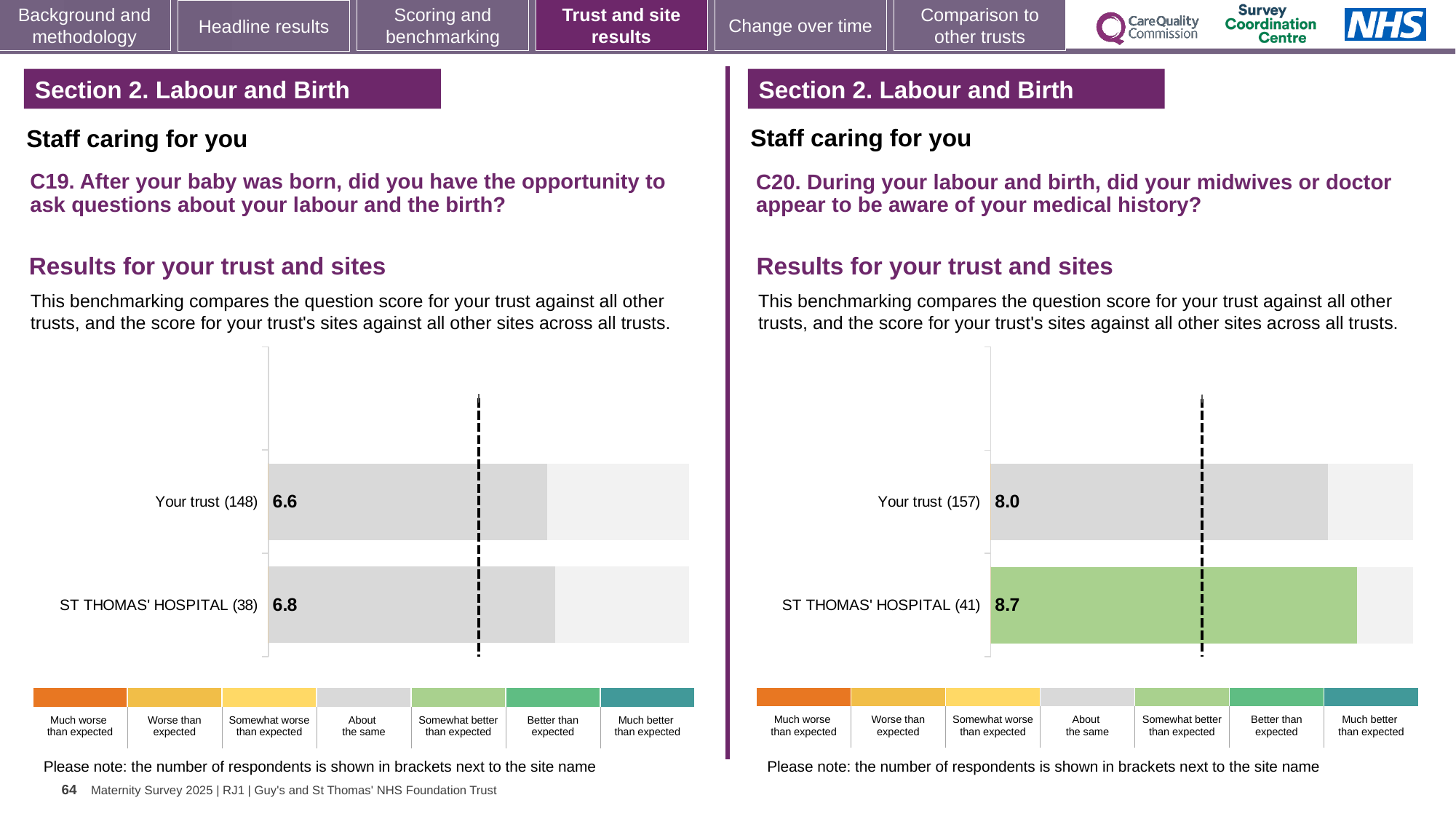
In the C19 chart on the left, what is the difference between the ST THOMAS' HOSPITAL score and the Your trust score? 0.2 How many bars are plotted in the C20 chart on the right? 2 In the C19 chart on the left, what is the score for Your trust? 6.6 In the C19 chart on the left, which bar has the lower score? Your trust In the C20 chart on the right, what is the difference between the ST THOMAS' HOSPITAL score and the Your trust score? 0.7 In the C20 chart on the right, which benchmark category does the colour of the ST THOMAS' HOSPITAL bar correspond to in the legend? Somewhat better than expected What type of chart is used in the C19 chart on the left? bar chart In the C20 chart on the right, which bar has the higher score? ST THOMAS' HOSPITAL In the C19 chart on the left, is the score for Your trust larger or smaller than the score for ST THOMAS' HOSPITAL? smaller In the C20 chart on the right, what is the score for ST THOMAS' HOSPITAL? 8.7 In the C19 chart on the left, what is the score for ST THOMAS' HOSPITAL? 6.8 In the C20 chart on the right, what is the score for Your trust? 8.0